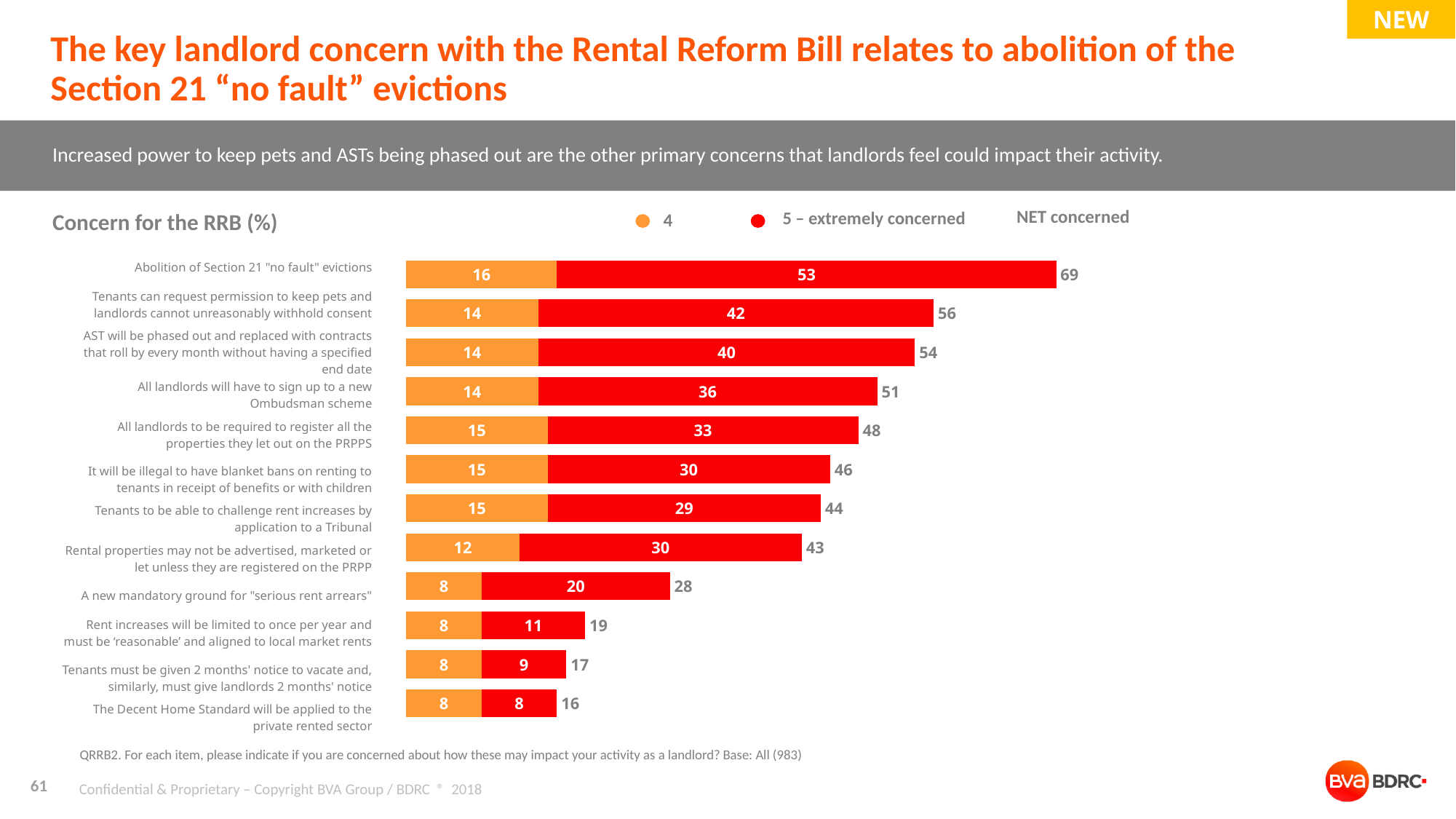
Which item has the highest NET concerned value? Abolition of Section 21 "no fault" evictions What is the '5 – extremely concerned' value for 'Abolition of Section 21 "no fault" evictions'? 53 What is the total of the stacked bar for 'Tenants to be able to challenge rent increases by application to a Tribunal'? 44 What is the title of the chart? Concern for the RRB (%) What is the difference between the NET concerned values for 'Abolition of Section 21 "no fault" evictions' and 'Tenants can request permission to keep pets and landlords cannot unreasonably withhold consent'? 13 Which item has the lowest NET concerned value? The Decent Home Standard will be applied to the private rented sector How many series does the legend list? 2 How many items are shown in the chart? 12 What kind of chart is shown on the slide? Stacked bar chart Which has a larger '5 – extremely concerned' value: 'All landlords to be required to register all the properties they let out on the PRPPS' or 'A new mandatory ground for "serious rent arrears"'? All landlords to be required to register all the properties they let out on the PRPPS What is the NET concerned value for 'All landlords will have to sign up to a new Ombudsman scheme'? 51 What is the '4' value for 'Rental properties may not be advertised, marketed or let unless they are registered on the PRPP'? 12